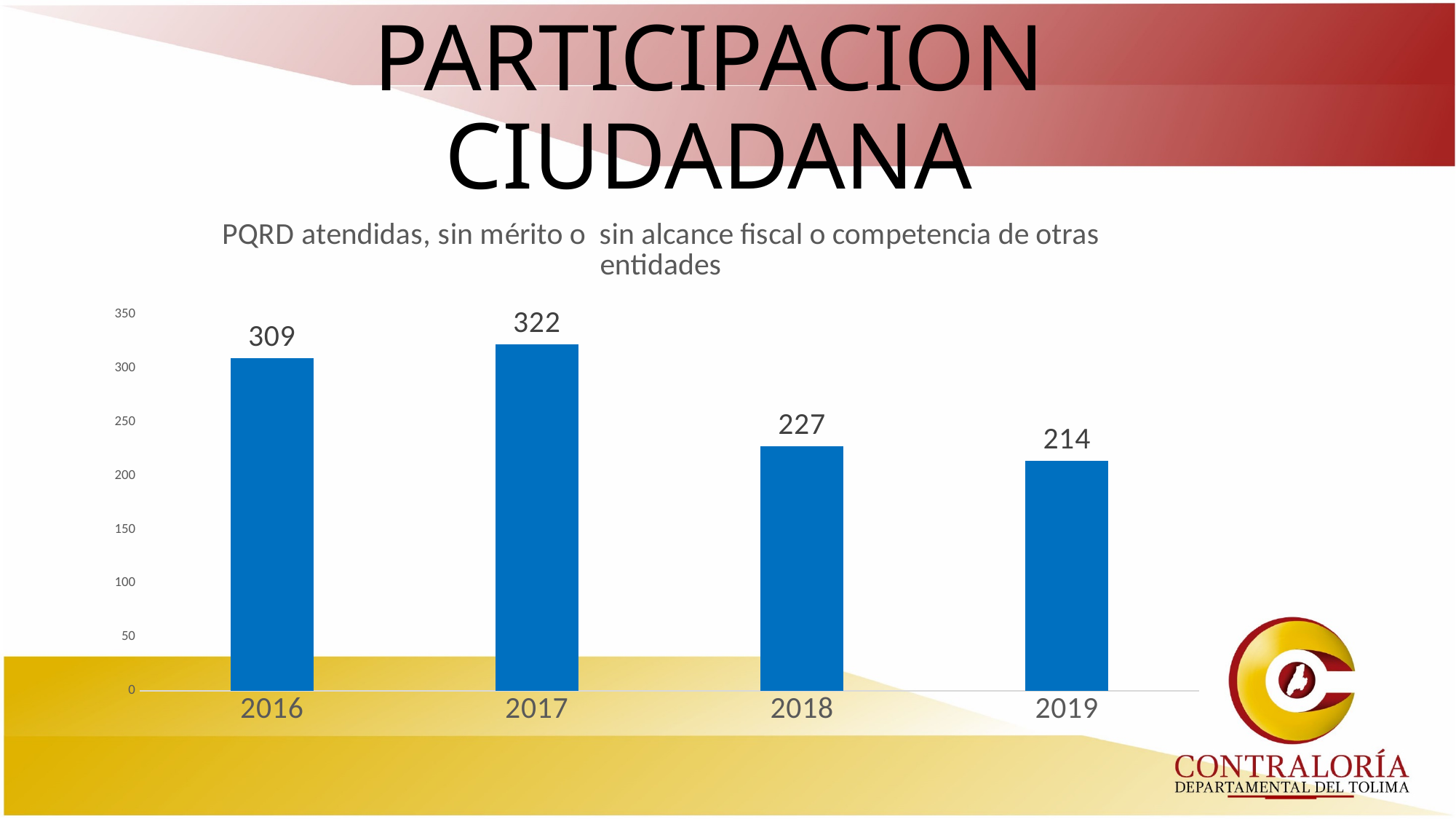
What kind of chart is shown on the slide? bar chart Which year has the highest value? 2017 Is the value for 2018 greater or less than 250? less What is the difference between the values for 2017 and 2019? 108 Which is larger, the value for 2016 or the value for 2018? 2016 What is the value for 2017? 322 What is the title of the chart? PQRD atendidas, sin mérito o sin alcance fiscal o competencia de otras entidades What is the value for 2019? 214 Which year has the lowest value? 2019 What is the value for 2016? 309 What is the value for 2018? 227 How many years are shown on the x axis? 4